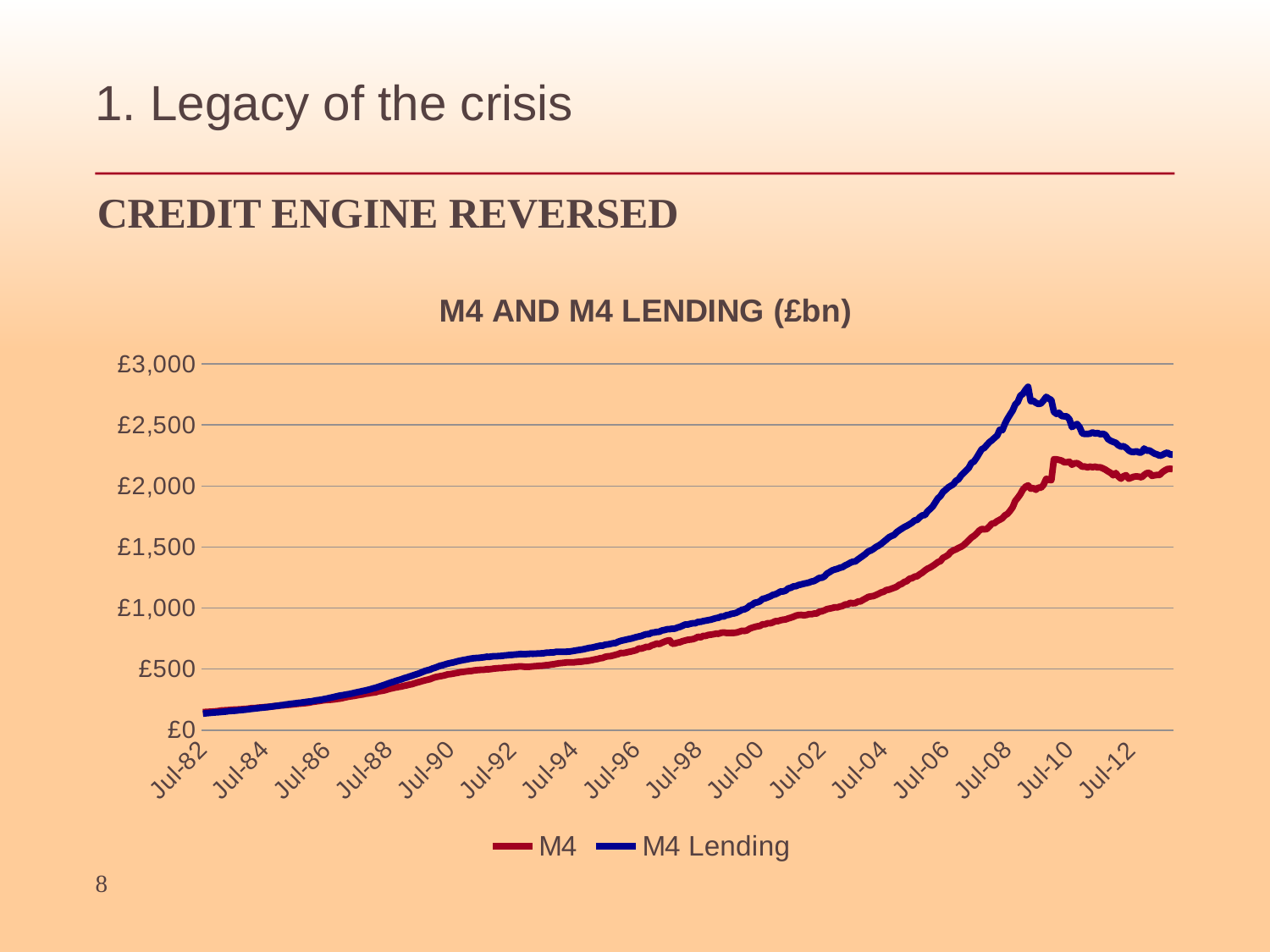
Is the peak value of M4 Lending greater or less than £2,500? greater Is the value for M4 Lending at Jul-06 greater or less than £1,500? greater What kind of chart is shown on the slide? line chart Does the M4 Lending series rise or fall between Jul-82 and Jul-08? rise Which series is drawn in blue? M4 Lending Is the value for M4 at Jul-12 greater or less than £2,000? greater At Jul-10, which series has the higher value, M4 or M4 Lending? M4 Lending How many series does the legend list? 2 What is the title of the chart? M4 AND M4 LENDING (£bn) How many date labels are shown on the x axis? 16